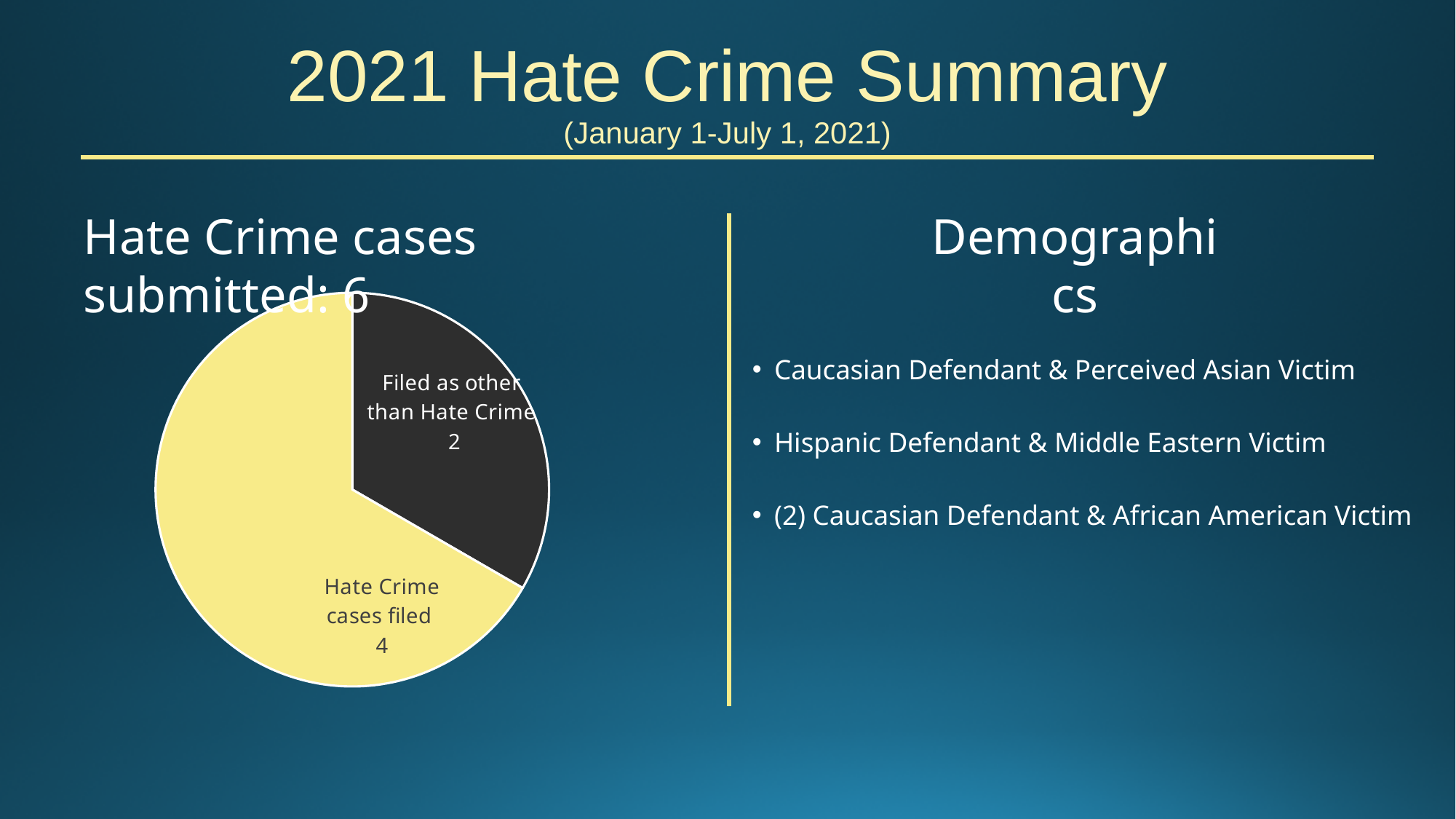
What colour is the "Hate Crime cases filed" slice in the pie chart? Yellow What colour is the "Filed as other than Hate Crime" slice in the pie chart? Dark grey What is the value for "Hate Crime cases filed" in the pie chart? 4 What share of the pie does "Hate Crime cases filed" represent? 2/3 What is the value for "Filed as other than Hate Crime" in the pie chart? 2 What type of chart is shown on the slide? Pie chart What is the total of all slices in the pie chart? 6 Which is larger: Hate Crime cases filed or cases filed as other than Hate Crime? Hate Crime cases filed What is the difference between the number of Hate Crime cases filed and the number filed as other than Hate Crime? 2 Which slice of the pie chart is the smallest? Filed as other than Hate Crime How many slices does the pie chart have? 2 Which slice of the pie chart is the largest? Hate Crime cases filed